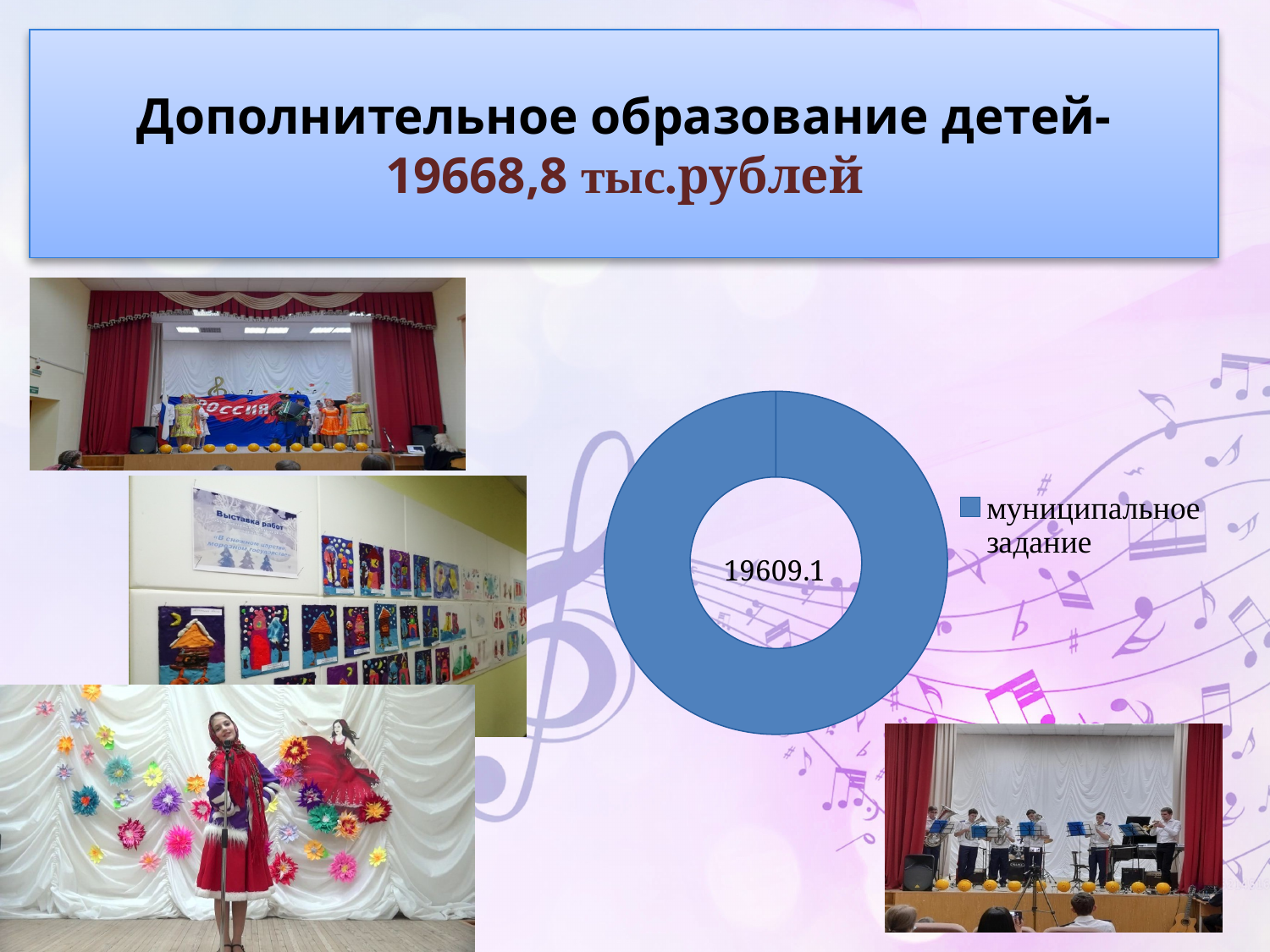
What kind of chart is shown on the slide? doughnut chart What colour is the муниципальное задание slice in the doughnut chart? blue How many entries does the legend of the doughnut chart list? 1 What share of the doughnut chart does муниципальное задание occupy? 100% What value is shown on the doughnut chart for муниципальное задание? 19609.1 Is the value for муниципальное задание greater or less than 19000? greater What is the label of the only entry in the chart's legend? муниципальное задание How many categories does the doughnut chart contain? 1